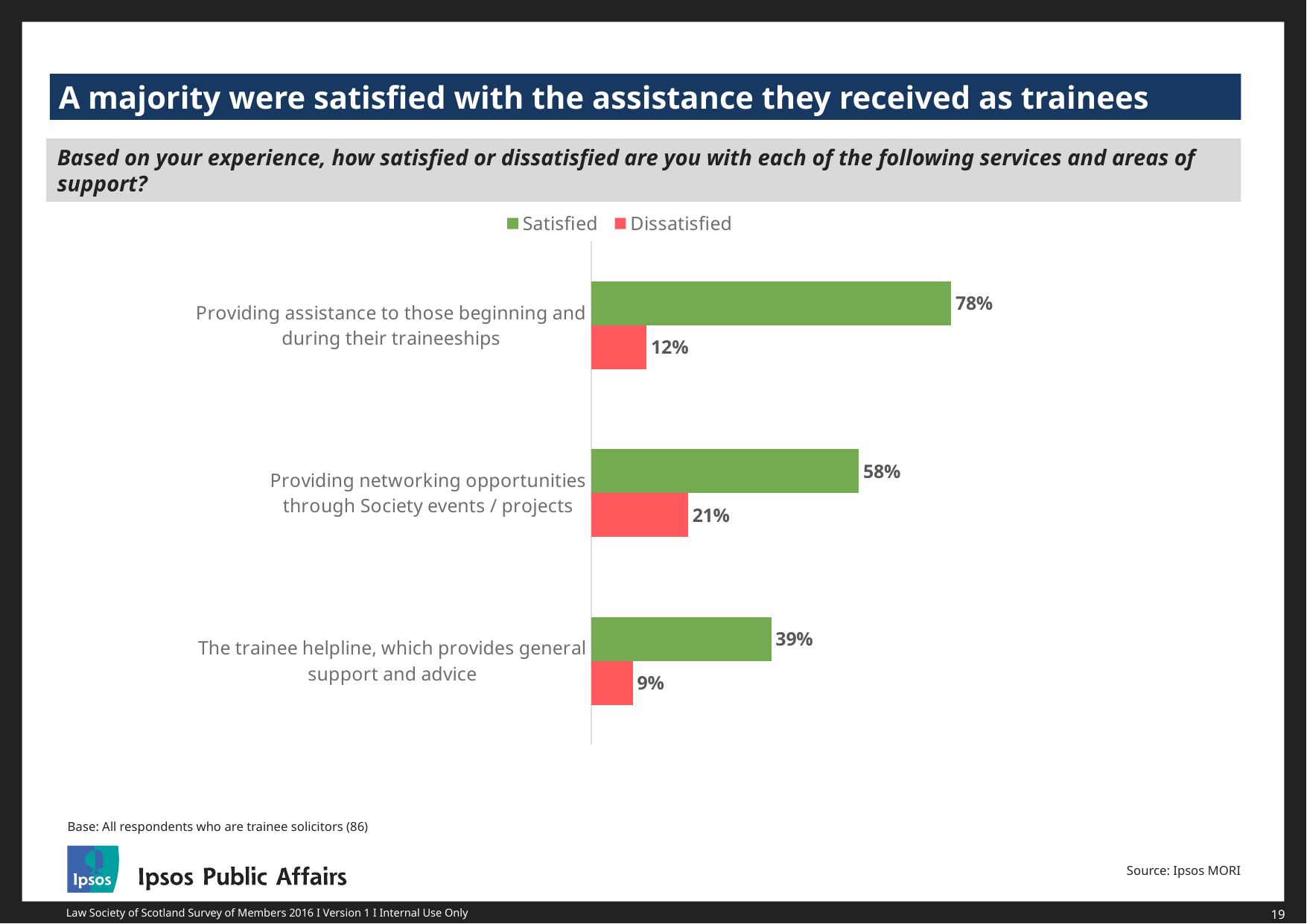
Which is larger: the satisfied percentage for the trainee helpline or the satisfied percentage for providing networking opportunities? Providing networking opportunities What kind of chart is shown on the slide? Bar chart Which service has the highest satisfied percentage? Providing assistance to those beginning and during their traineeships What is the difference between the satisfied and dissatisfied percentages for providing networking opportunities through Society events / projects? 37 percentage points What percentage were dissatisfied with providing networking opportunities through Society events / projects? 21% What percentage were satisfied with providing assistance to those beginning and during their traineeships? 78% Which colour represents the Dissatisfied series in the chart? Red What percentage were dissatisfied with the trainee helpline? 9% Which service has the lowest dissatisfied percentage? The trainee helpline, which provides general support and advice How many services are shown in the chart? 3 How many series does the legend list? 2 What percentage were satisfied with the trainee helpline, which provides general support and advice? 39%